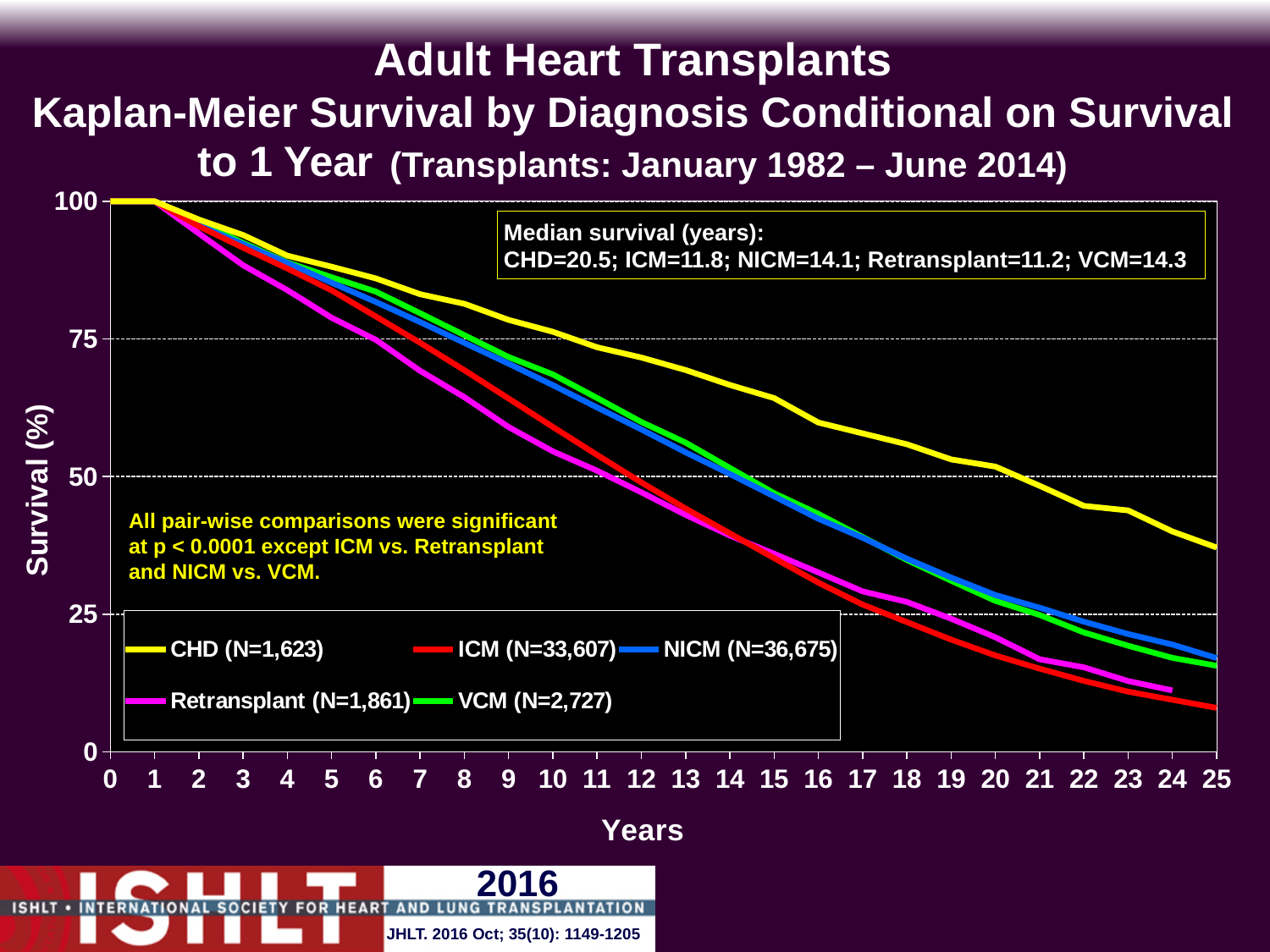
What is the median survival in years for Retransplant? 11.2 Is the survival value for ICM at 25 years greater or less than 25? less Do the survival curves rise or fall as years increase? fall Which diagnosis has the highest median survival? CHD Which diagnosis has the lowest median survival? Retransplant What kind of chart is shown on the slide? line chart Which has a higher median survival, NICM or VCM? VCM What is the median survival in years for CHD? 20.5 What is the difference in median survival (years) between CHD and ICM? 8.7 How many series does the legend list? 5 Which series in the legend has the largest N? NICM (N=36,675) Is the survival value for CHD at 25 years greater or less than 25? greater